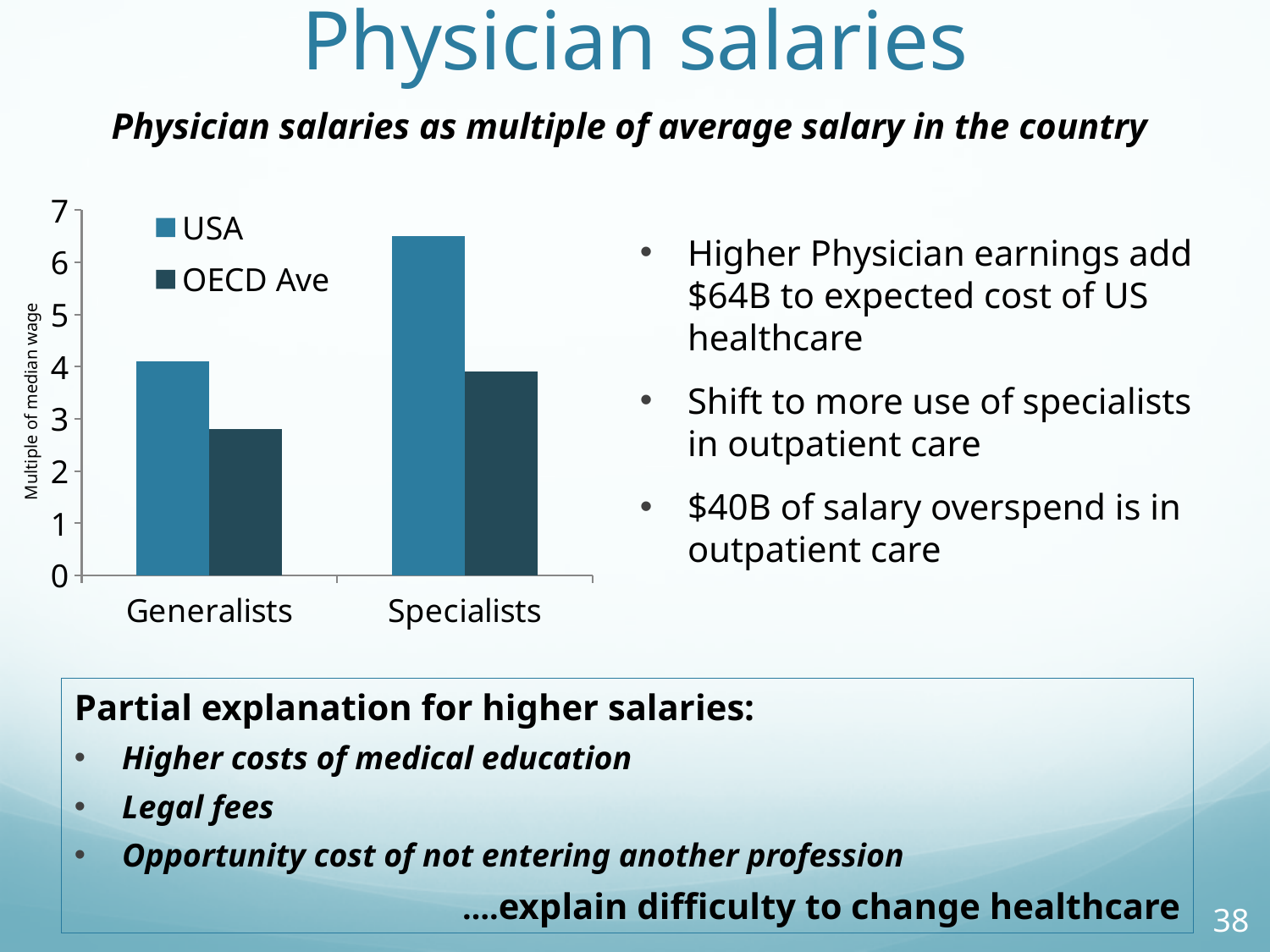
How many categories are shown on the x axis of the chart? 2 What kind of chart is shown on the slide? bar chart Is the USA value for Specialists greater or less than 6? greater Which bar is the tallest in the chart? USA Specialists Is the OECD Ave value for Generalists greater or less than 3? less For Specialists, which is larger: the USA value or the OECD Ave value? USA What is the label on the vertical axis of the chart? Multiple of median wage Which bar is the shortest in the chart? OECD Ave Generalists How many series does the chart legend list? 2 Which series are listed in the chart legend? USA and OECD Ave